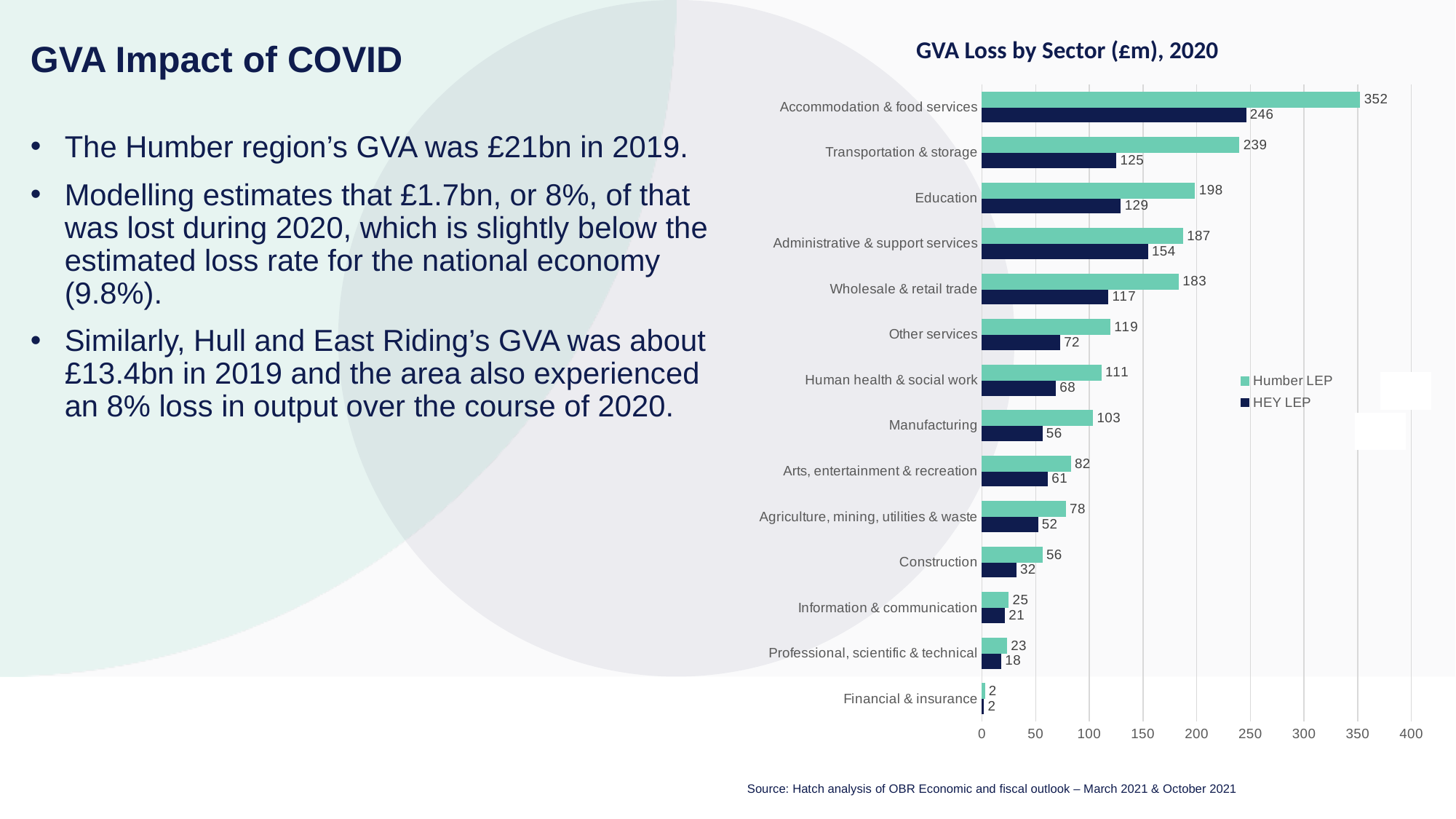
What is the title of the chart? GVA Loss by Sector (£m), 2020 Which is larger: the HEY LEP value for Administrative & support services or the HEY LEP value for Wholesale & retail trade? Administrative & support services Which sector has the highest Humber LEP GVA loss? Accommodation & food services What is the HEY LEP GVA loss for Transportation & storage? 125 How many series does the legend list? 2 Is the Humber LEP value for Other services greater or less than 100? greater What is the difference between the Humber LEP and HEY LEP values for Education? 69 What type of chart is shown? Bar chart Which sector has the lowest HEY LEP GVA loss? Financial & insurance What is the Humber LEP GVA loss for Accommodation & food services? 352 What is the Humber LEP value for Manufacturing? 103 How many sectors are shown on the chart? 14